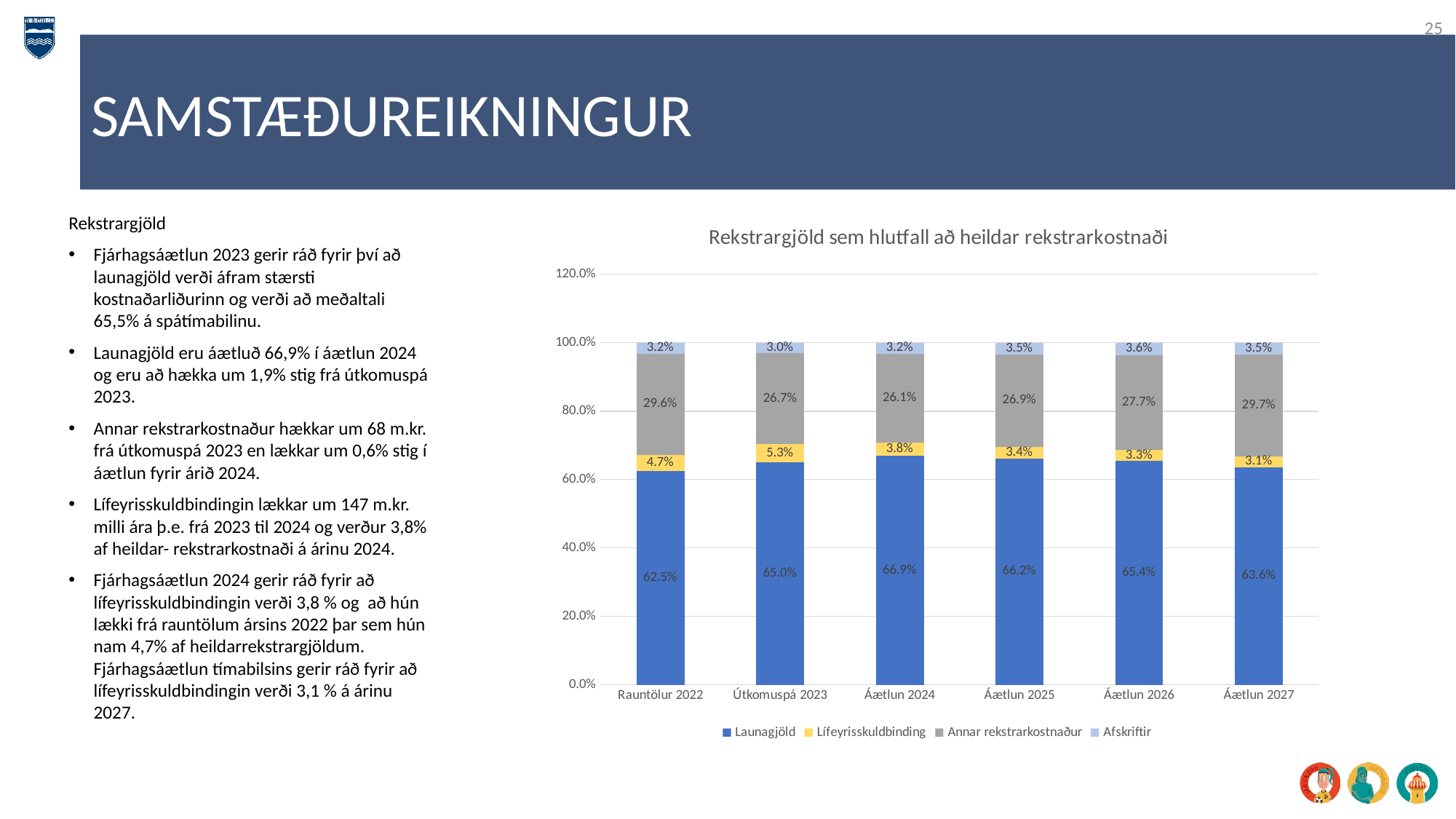
What is the Annar rekstrarkostnaður value for Áætlun 2027? 29.7% What is the Lífeyrisskuldbinding value for Rauntölur 2022? 4.7% How many categories are shown on the x axis? 6 Which category has the highest Launagjöld value? Áætlun 2024 What kind of chart is shown on the slide? Stacked bar chart What is the Launagjöld value for Áætlun 2024? 66.9% Which is larger, the Annar rekstrarkostnaður value for Rauntölur 2022 or for Áætlun 2024? Rauntölur 2022 What is the Afskriftir value for Útkomuspá 2023? 3.0% What is the title of the chart? Rekstrargjöld sem hlutfall að heildar rekstrarkostnaði Which category has the lowest Lífeyrisskuldbinding value? Áætlun 2027 How many series does the legend list? 4 What is the difference between the Launagjöld values for Áætlun 2024 and Útkomuspá 2023? 1.9%